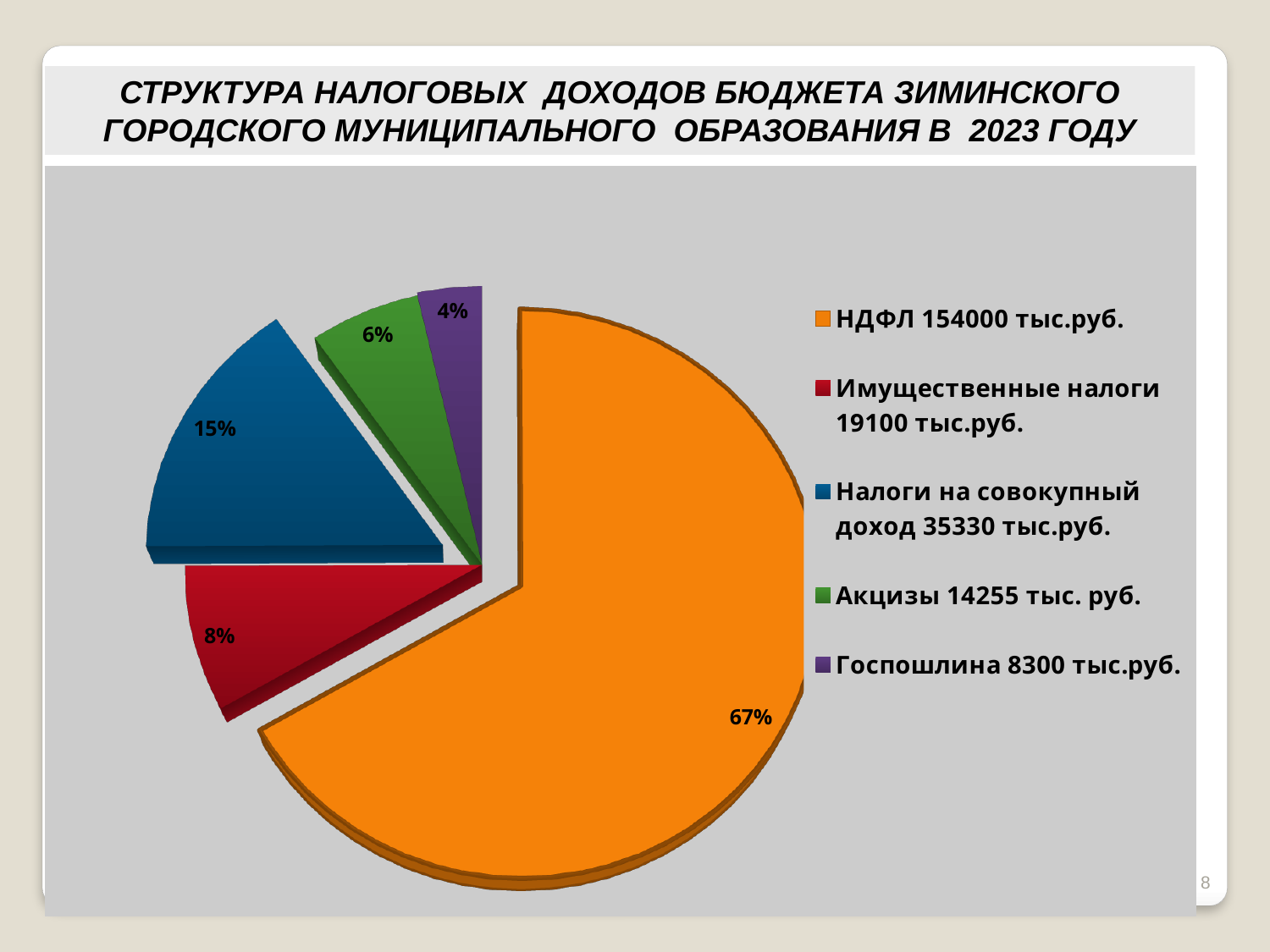
What kind of chart is shown on the slide? pie chart What share of the pie does Госпошлина account for? 4% What share of the pie does Имущественные налоги account for? 8% Which is larger: the share for Имущественные налоги or the share for Акцизы? Имущественные налоги How many slices does the pie chart have? 5 What share of the pie does НДФЛ account for? 67% Which category has the smallest slice of the pie? Госпошлина According to the legend, what is the amount for Акцизы? 14255 тыс. руб. According to the legend, what is the amount for Налоги на совокупный доход? 35330 тыс.руб. What is the difference in percentage points between the НДФЛ share and the Налоги на совокупный доход share? 52 Which category has the largest slice of the pie? НДФЛ